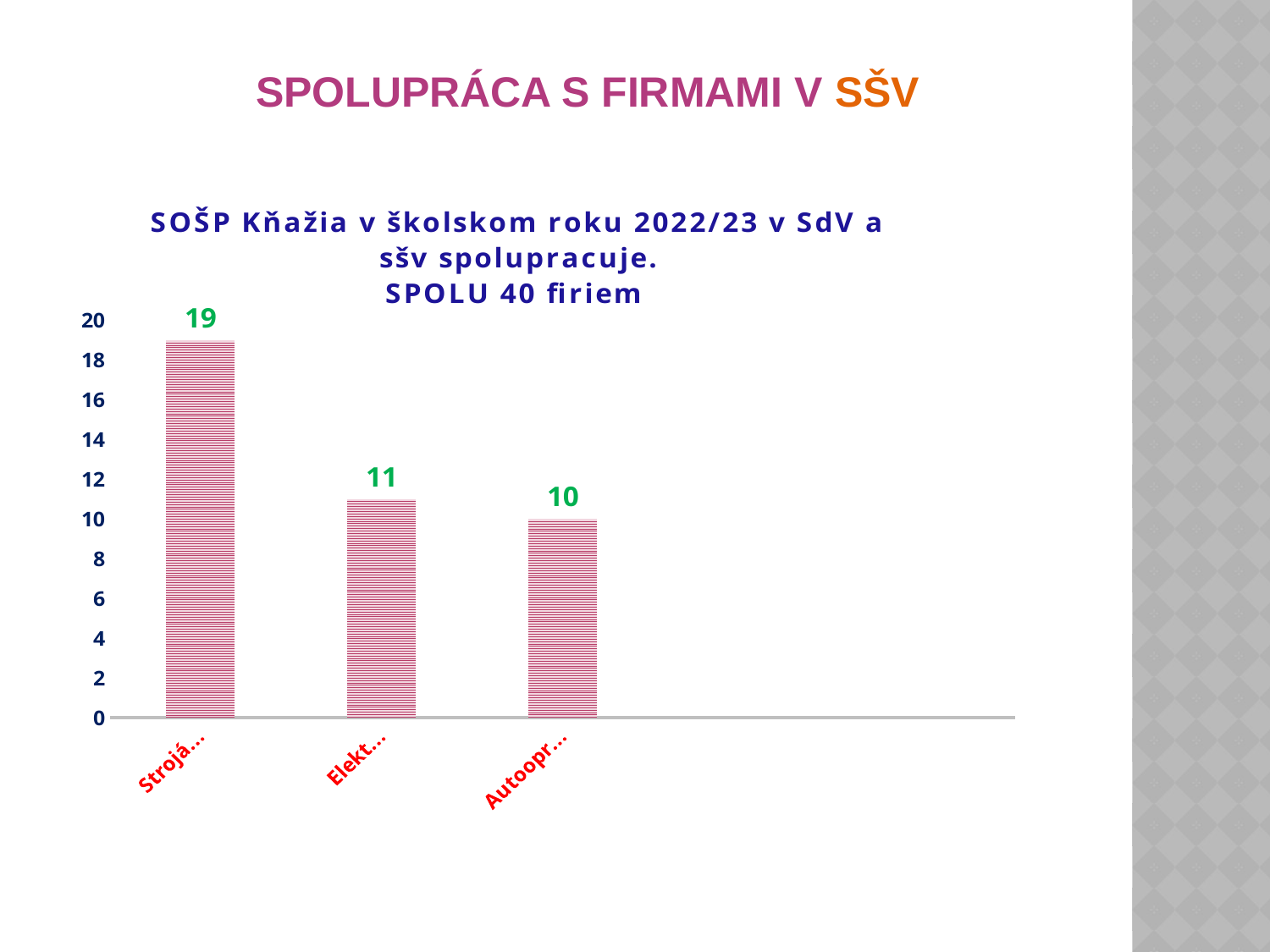
What is the value of the second bar (labelled "Elekt…")? 11 What is the value of the third bar (labelled "Autoopr…")? 10 Which bar has the highest value? The first bar (Strojá…) How many bars are plotted in the chart? 3 What is the difference between the first bar (19) and the third bar (10)? 9 Which is larger, the value of the second bar (Elekt…) or the third bar (Autoopr…)? The second bar (Elekt…) What is the difference between the first bar (19) and the second bar (11)? 8 What is the value of the first bar (labelled "Strojá…")? 19 What is the highest value shown on the vertical axis? 20 Do the bar values rise or fall from left to right? Fall Which bar has the lowest value? The third bar (Autoopr…) What kind of chart is shown on the slide? Bar chart